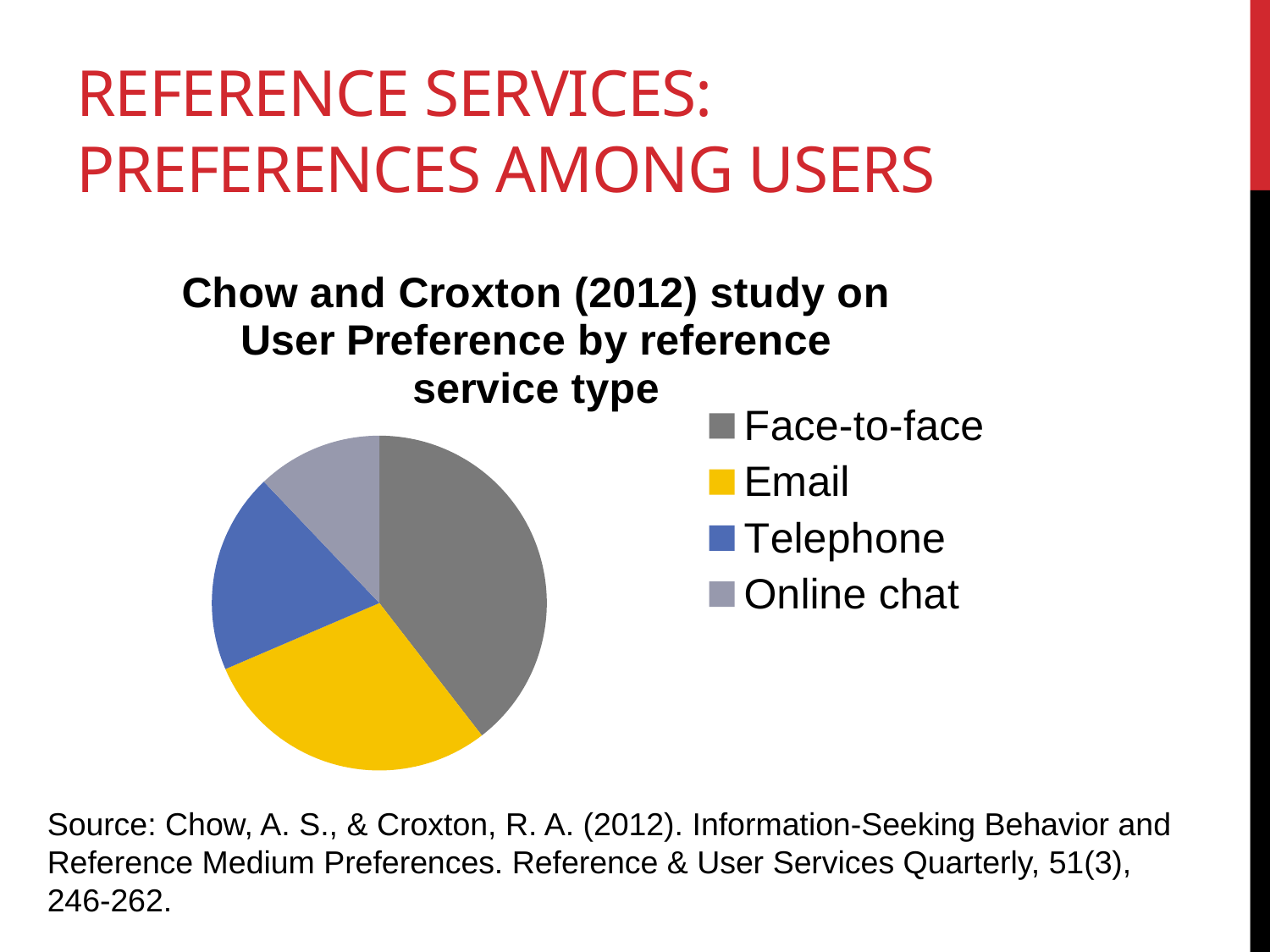
Which reference service type has the smallest slice of the pie chart? Online chat How many slices does the pie chart have? 4 What kind of chart is shown on the slide? Pie chart Which slice is larger in the pie chart, Email or Telephone? Email What is the title of the pie chart? Chow and Croxton (2012) study on User Preference by reference service type Which slice is larger in the pie chart, Telephone or Online chat? Telephone Which reference service type has the largest slice of the pie chart? Face-to-face Which slice is larger in the pie chart, Face-to-face or Email? Face-to-face How many entries does the legend of the pie chart list? 4 Which reference service type is shown in yellow in the pie chart? Email